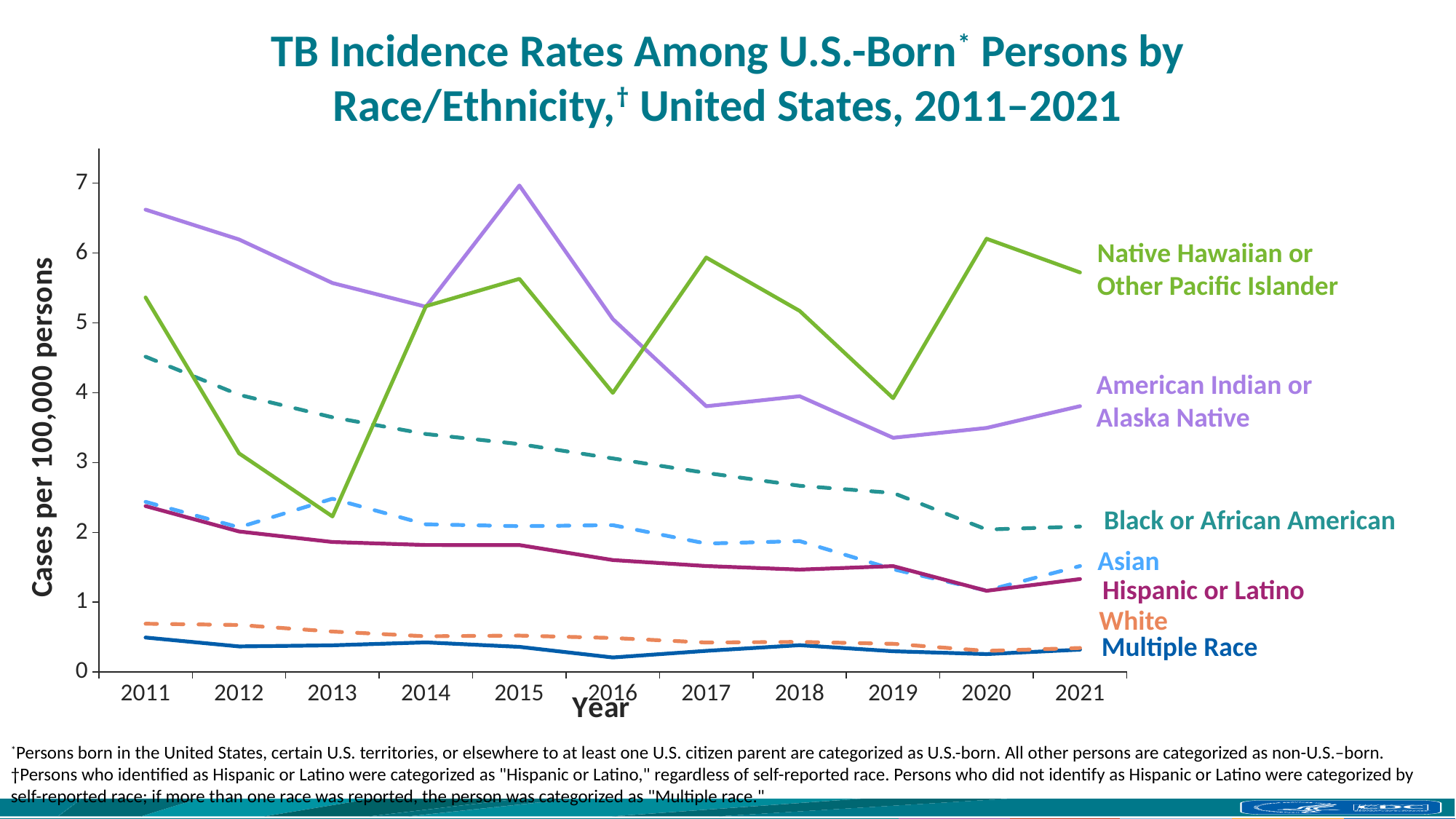
What is the label on the y axis of the chart? Cases per 100,000 persons Does the TB incidence rate for Black or African American persons rise or fall from 2011 to 2021? fall Which race/ethnicity group had the highest TB incidence rate in 2011? American Indian or Alaska Native What kind of chart is shown on the slide? line chart Which race/ethnicity group had the highest TB incidence rate in 2021? Native Hawaiian or Other Pacific Islander How many years are shown along the x axis? 11 In 2013, which group had the larger TB incidence rate: Native Hawaiian or Other Pacific Islander, or American Indian or Alaska Native? American Indian or Alaska Native How many race/ethnicity series are plotted on the chart? 7 Which race/ethnicity group had the lowest TB incidence rate in 2011? Multiple Race Is the 2015 value for American Indian or Alaska Native greater or less than 6? greater Is the 2011 value for Black or African American greater or less than 4? greater Is the 2013 value for Native Hawaiian or Other Pacific Islander greater or less than 3? less